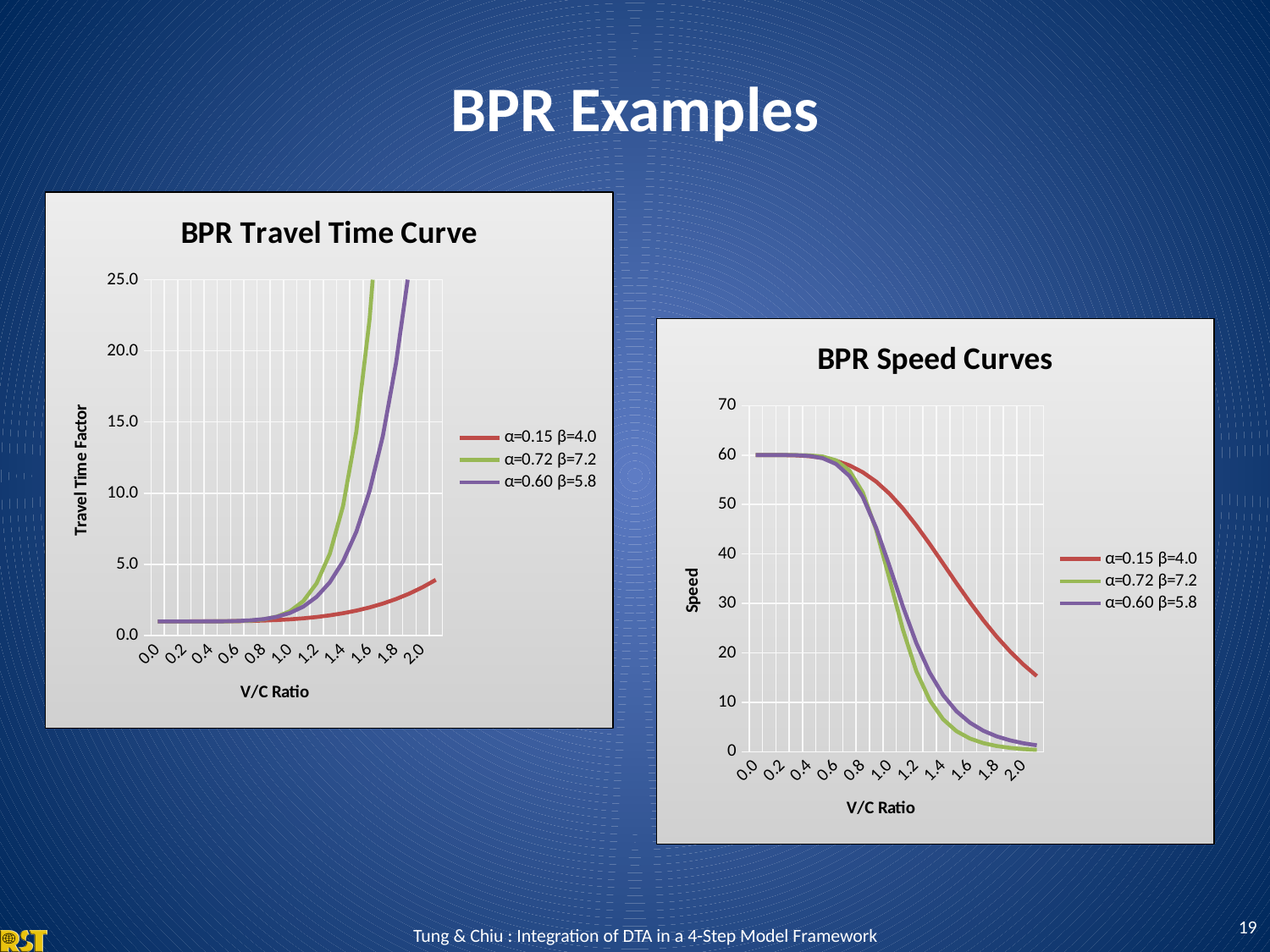
In the BPR Speed Curves chart, at V/C Ratio 1.6, which is larger: the α=0.15 β=4.0 series or the α=0.72 β=7.2 series? α=0.15 β=4.0 In the BPR Travel Time Curve chart, is the value of the α=0.15 β=4.0 series at V/C Ratio 2.0 greater or less than 5.0? less In the BPR Speed Curves chart, is the value of the α=0.15 β=4.0 series at V/C Ratio 2.0 greater or less than 10? greater What is the x-axis label of the BPR Travel Time Curve chart? V/C Ratio In the BPR Speed Curves chart, which series has the highest value at V/C Ratio 2.0? α=0.15 β=4.0 In the BPR Travel Time Curve chart, is the value of the α=0.72 β=7.2 series at V/C Ratio 1.6 greater or less than 20.0? greater In the BPR Speed Curves chart, do the values rise or fall as the V/C Ratio increases? fall In the BPR Travel Time Curve chart, do the values rise or fall as the V/C Ratio increases? rise How many series does the legend of the BPR Speed Curves chart list? 3 What kind of chart is the BPR Travel Time Curve chart? line chart What is the y-axis label of the BPR Speed Curves chart? Speed